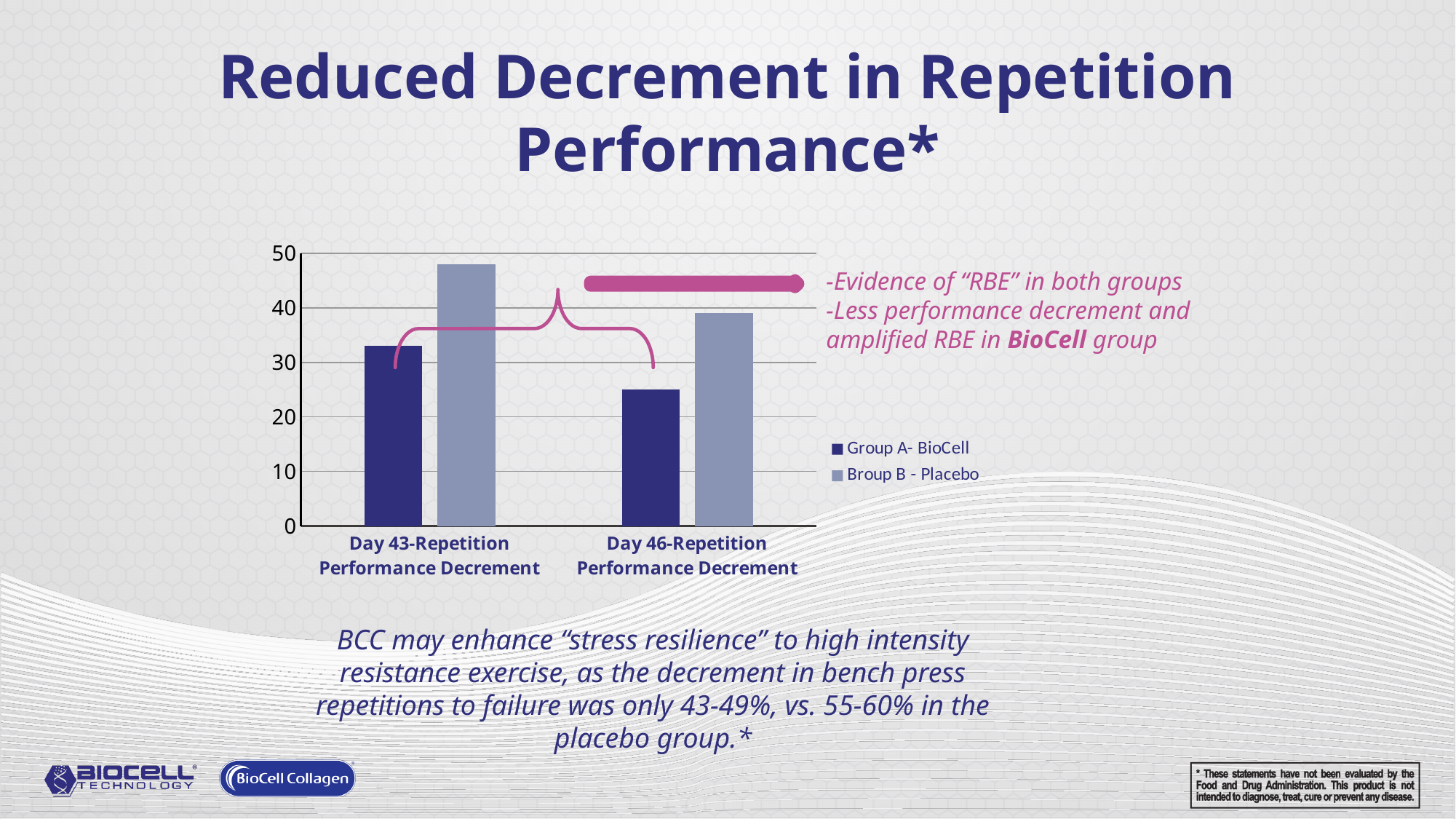
Is the Group A- BioCell value for Day 46-Repetition Performance Decrement greater or less than 30? less Is the Broup B - Placebo value for Day 46-Repetition Performance Decrement greater or less than 30? greater Which bar in the chart is the shortest? Group A- BioCell, Day 46-Repetition Performance Decrement How many categories are shown on the x axis of the chart? 2 Does the Group A- BioCell value rise or fall from Day 43 to Day 46? fall For Day 46-Repetition Performance Decrement, which series has the larger value, Group A- BioCell or Broup B - Placebo? Broup B - Placebo Is the Broup B - Placebo value for Day 43-Repetition Performance Decrement greater or less than 40? greater What kind of chart is shown on the slide? bar chart What is the title of the slide containing the chart? Reduced Decrement in Repetition Performance* Which bar in the chart is the tallest? Broup B - Placebo, Day 43-Repetition Performance Decrement How many series does the chart legend list? 2